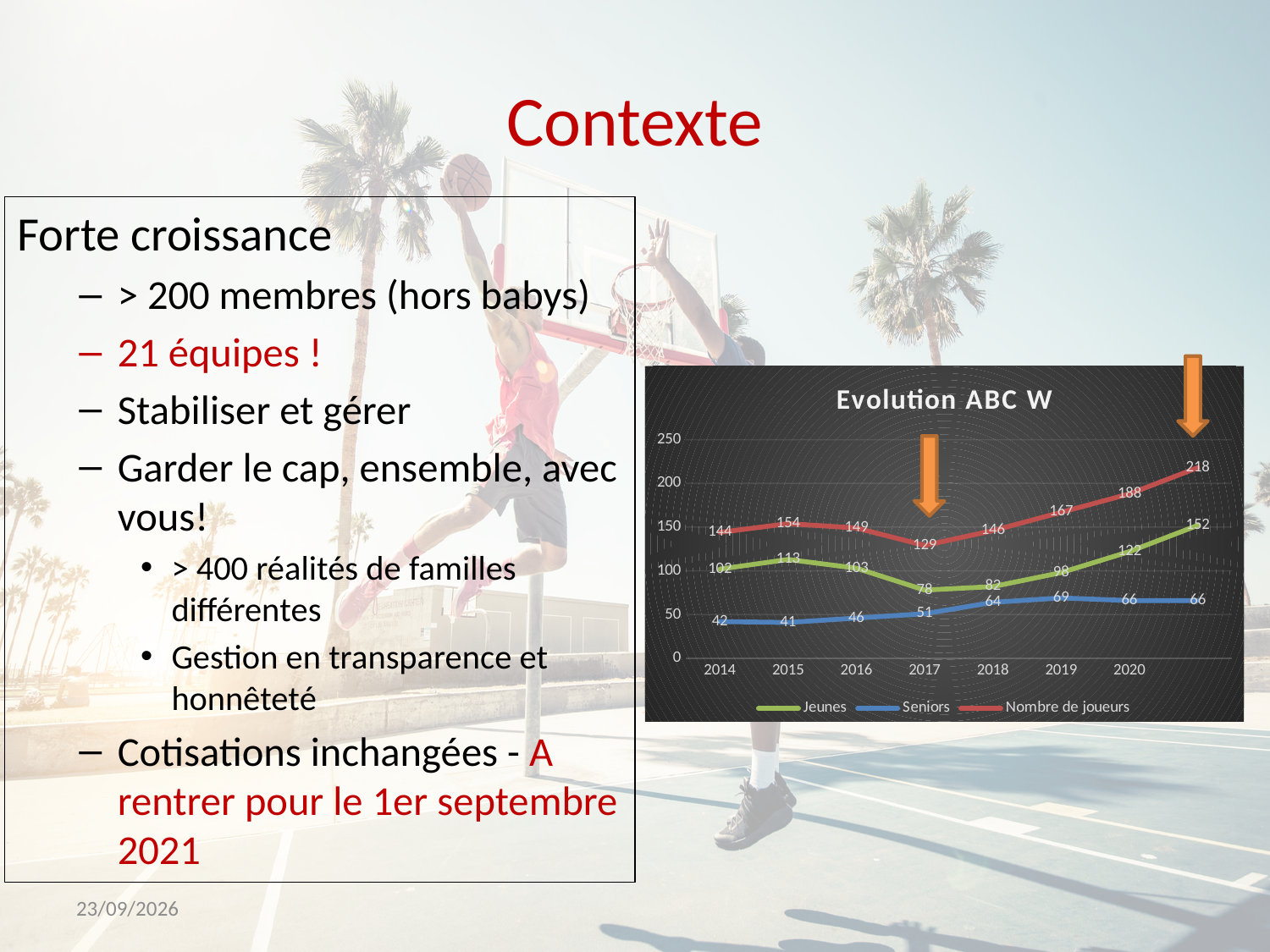
What is the title of the chart? Evolution ABC W How many series does the chart legend list? 3 What is the value of Seniors in 2018? 64 In 2016, which is larger: Jeunes or Seniors? Jeunes What is the difference between Nombre de joueurs in 2020 and in 2014? 44 In which year is the Jeunes series at its lowest? 2017 What is the value of Jeunes in 2014? 102 What kind of chart is shown on the slide? line chart What is the highest value shown for Nombre de joueurs? 218 In which year is the Seniors series at its lowest? 2015 Does the Nombre de joueurs series rise or fall from 2017 to 2020? rise What is the value of Nombre de joueurs in 2017? 129